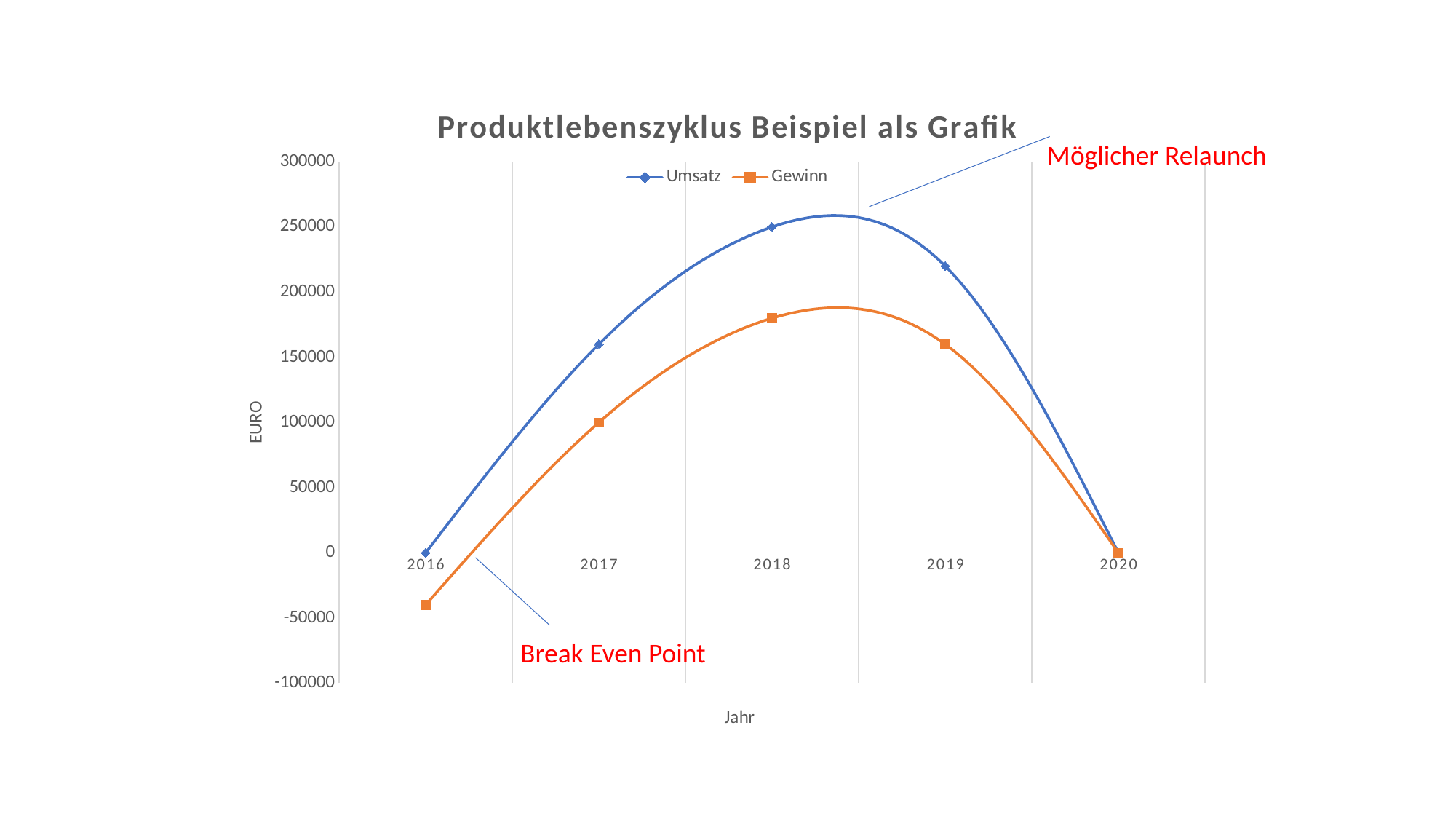
Does Umsatz rise or fall from 2018 to 2020? Fall Is the value for Umsatz in 2017 greater or less than 150000? greater Which is larger in 2019, Umsatz or Gewinn? Umsatz Is the value for Gewinn in 2018 greater or less than 200000? less Is the value for Gewinn in 2016 greater or less than 0? less How many series does the legend list? 2 What is the value of Gewinn in 2020? 0 What is the value of Umsatz in 2016? 0 What type of chart is shown on the slide? Line chart In which year is Gewinn at its lowest? 2016 In which year does Umsatz reach its highest value? 2018 How many years are shown on the x axis? 5